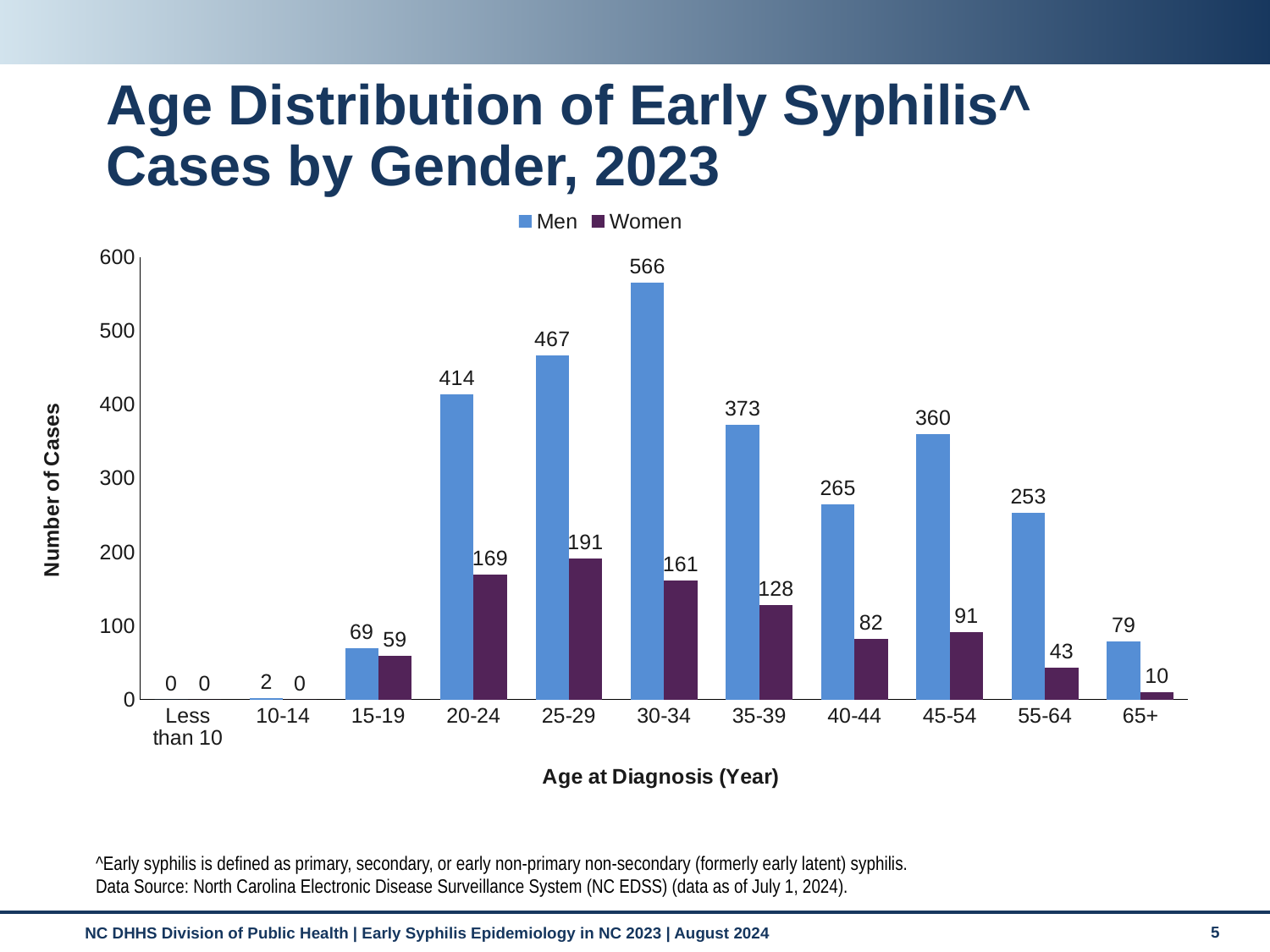
How many series does the legend list? 2 Which is larger: the number of men cases in the 35-39 age group or in the 45-54 age group? 35-39 What kind of chart is shown on the slide? bar chart What is the label of the y axis? Number of Cases What is the total number of cases (men plus women) in the 65+ age group? 89 How many early syphilis cases were there among men aged 30-34? 566 What is the difference between the number of men and women cases in the 20-24 age group? 245 Which age group has the highest number of cases among men? 30-34 How many age groups are shown on the x axis? 11 Is the value for men aged 55-64 greater or less than 200? greater Which age group has the highest number of cases among women? 25-29 How many early syphilis cases were there among women aged 25-29? 191